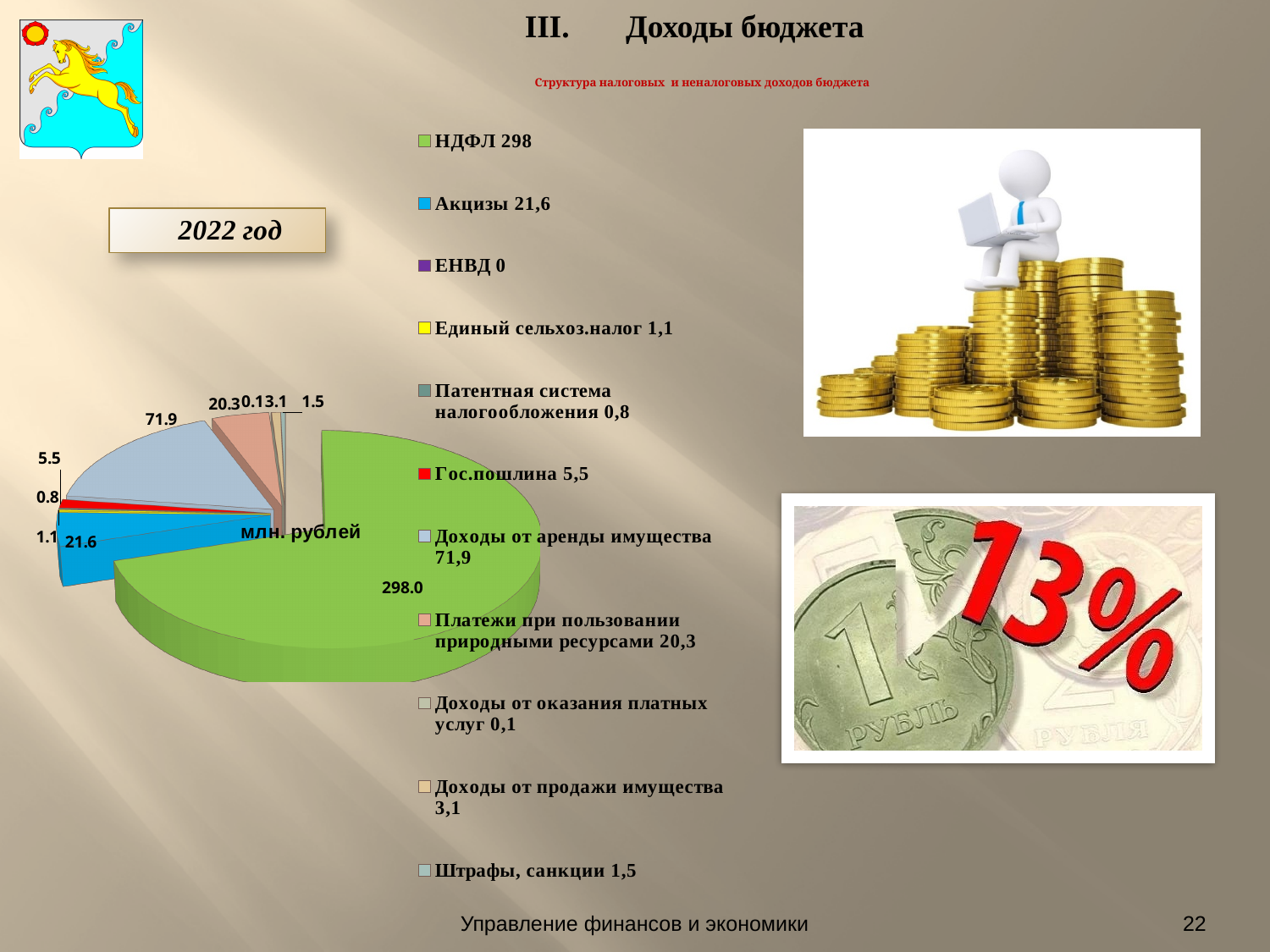
What value is shown for Акцизы in the pie chart? 21.6 What is the difference between the values for НДФЛ (298.0) and Доходы от аренды имущества (71.9)? 226.1 Which category in the legend has the smallest value? ЕНВД What value is shown for Гос.пошлина in the pie chart? 5.5 What is the difference between the values for Акцизы (21.6) and Платежи при пользовании природными ресурсами (20.3)? 1.3 What value is shown for Доходы от аренды имущества in the pie chart? 71.9 What kind of chart is shown on the slide? pie chart What value is shown for Штрафы, санкции in the pie chart? 1.5 Which category has the largest slice in the pie chart? НДФЛ Which is larger: Акцизы or Платежи при пользовании природными ресурсами? Акцизы How many categories does the legend of the pie chart list? 11